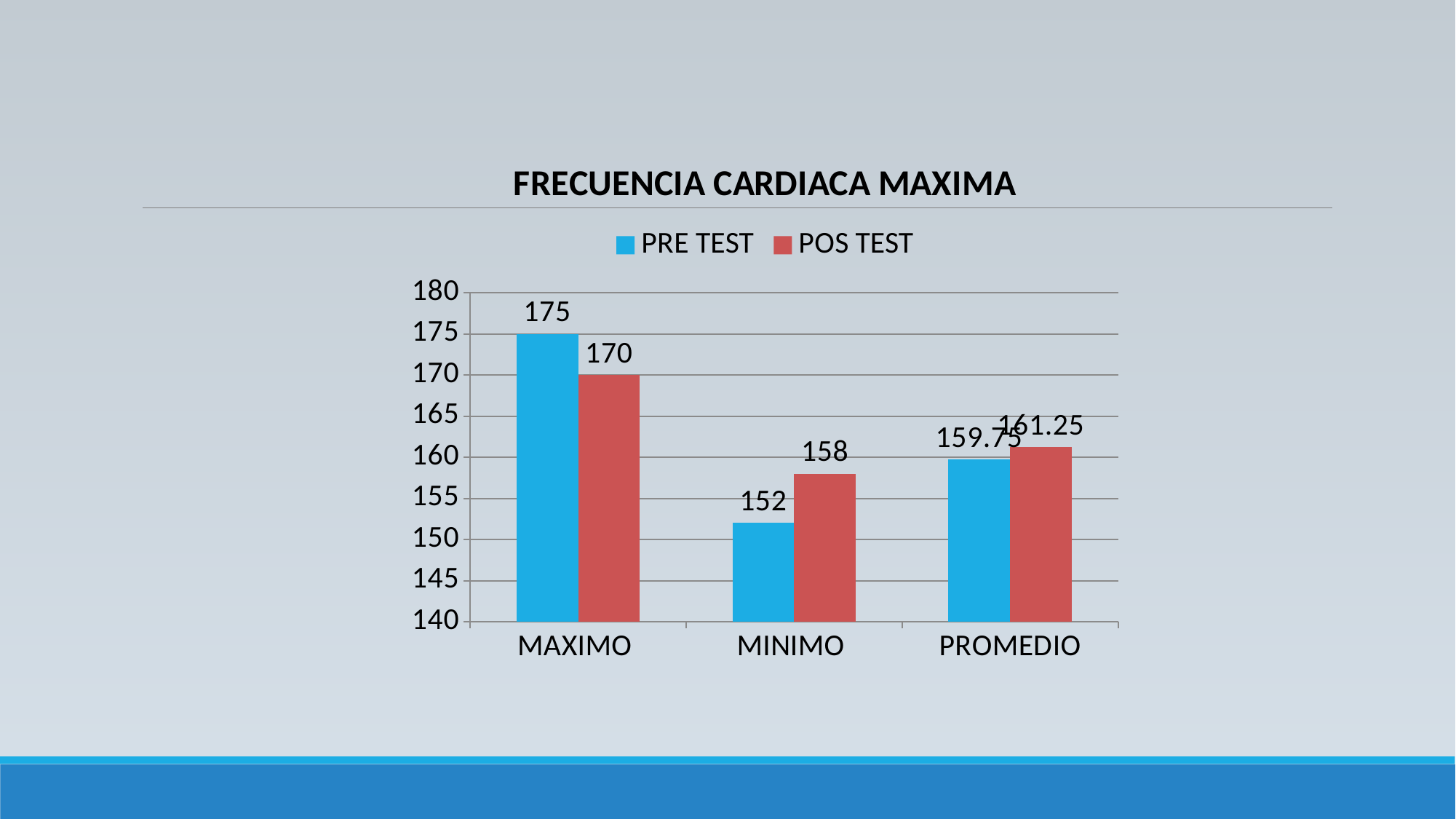
For MINIMO, which is larger: the PRE TEST value or the POS TEST value? POS TEST What is the difference between the POS TEST and PRE TEST values for MINIMO? 6 What is the difference between the PRE TEST and POS TEST values for MAXIMO? 5 Which category has the highest POS TEST value? MAXIMO How many series does the legend list? 2 What is the PRE TEST value for PROMEDIO? 159.75 How many categories are shown on the x axis? 3 What kind of chart is shown on the slide? Bar chart Which category has the lowest PRE TEST value? MINIMO What is the POS TEST value for PROMEDIO? 161.25 What is the PRE TEST value for MAXIMO? 175 What is the POS TEST value for MINIMO? 158